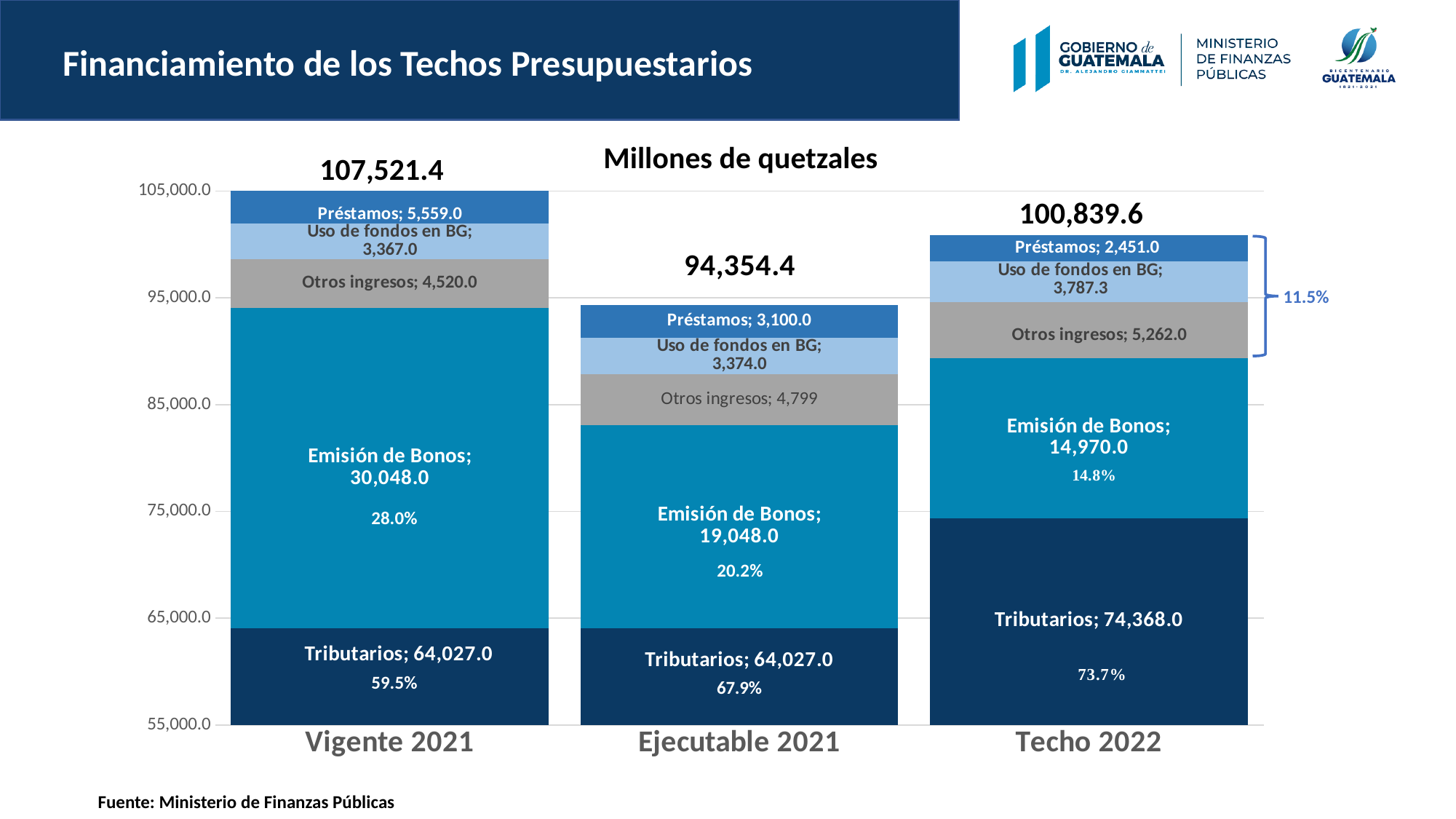
What is the difference between Emisión de Bonos for Vigente 2021 and for Ejecutable 2021? 11,000.0 What is the total value of the Ejecutable 2021 bar? 94,354.4 Which is larger: Uso de fondos en BG for Techo 2022 or for Vigente 2021? Techo 2022 What is the value of Emisión de Bonos for Techo 2022? 14,970.0 What kind of chart is shown on the slide? Stacked bar chart What is the total value of the Vigente 2021 bar? 107,521.4 Which category has the lowest total bar value? Ejecutable 2021 How many categories are shown along the x axis of the chart? 3 What is the value of Préstamos for Vigente 2021? 5,559.0 What is the value of Otros ingresos for Ejecutable 2021? 4,799 What is the value of Tributarios for Techo 2022? 74,368.0 Which category has the highest total bar value? Vigente 2021